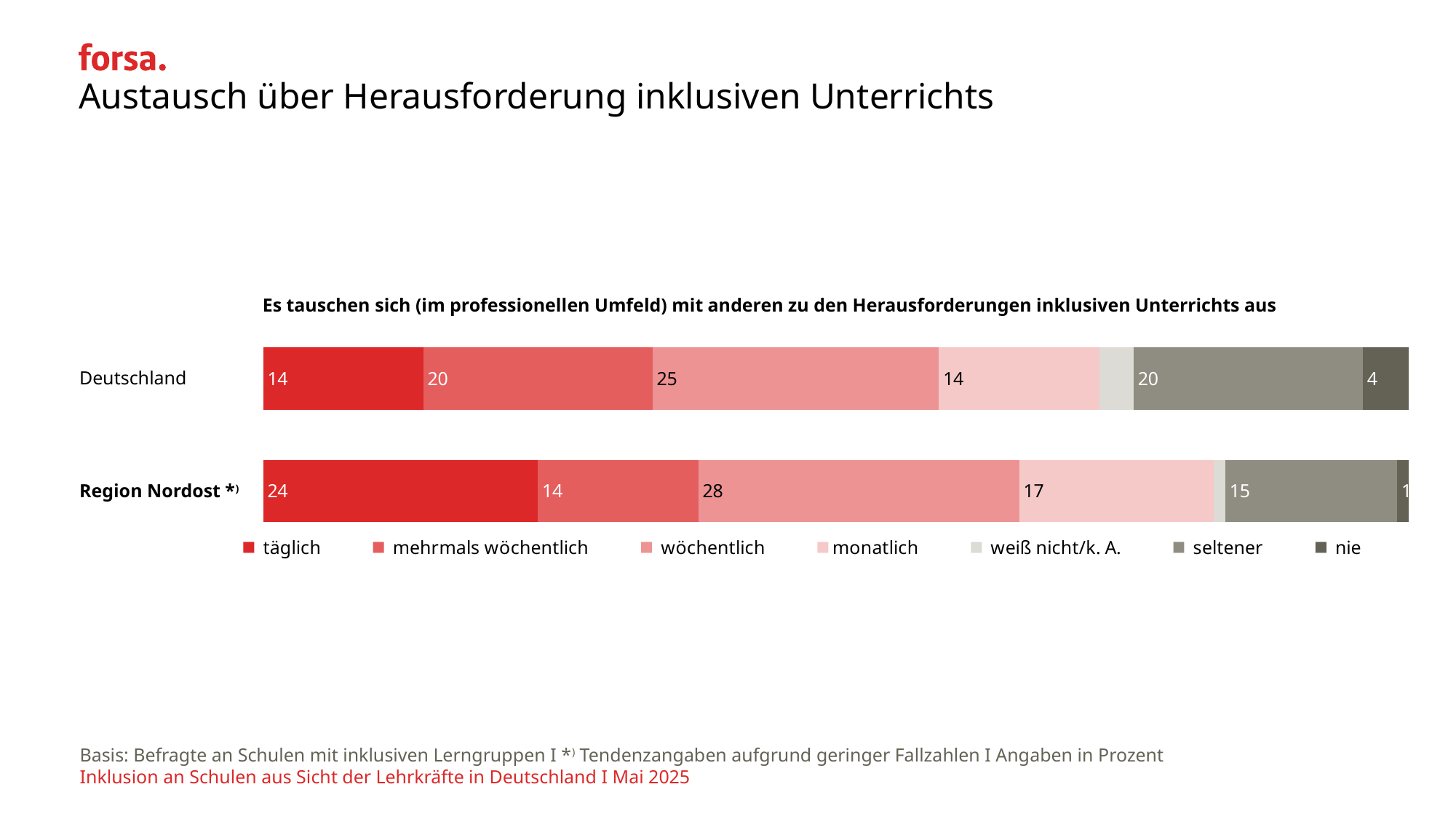
What is the value for "täglich" for Deutschland? 14 Which series is shown in the darkest grey colour in the legend? nie What is the value for "nie" for Region Nordost? 1 Which series has the largest value in the Deutschland bar? wöchentlich What is the difference between the "täglich" values for Region Nordost and Deutschland? 10 How many series does the legend list? 7 What type of chart is shown on the slide? stacked bar chart What is the value for "seltener" for Deutschland? 20 How many categories (bars) are shown in the chart? 2 What is the value for "wöchentlich" for Region Nordost? 28 Which category has the higher value for "täglich", Deutschland or Region Nordost? Region Nordost What is the difference between the "wöchentlich" values for Region Nordost and Deutschland? 3